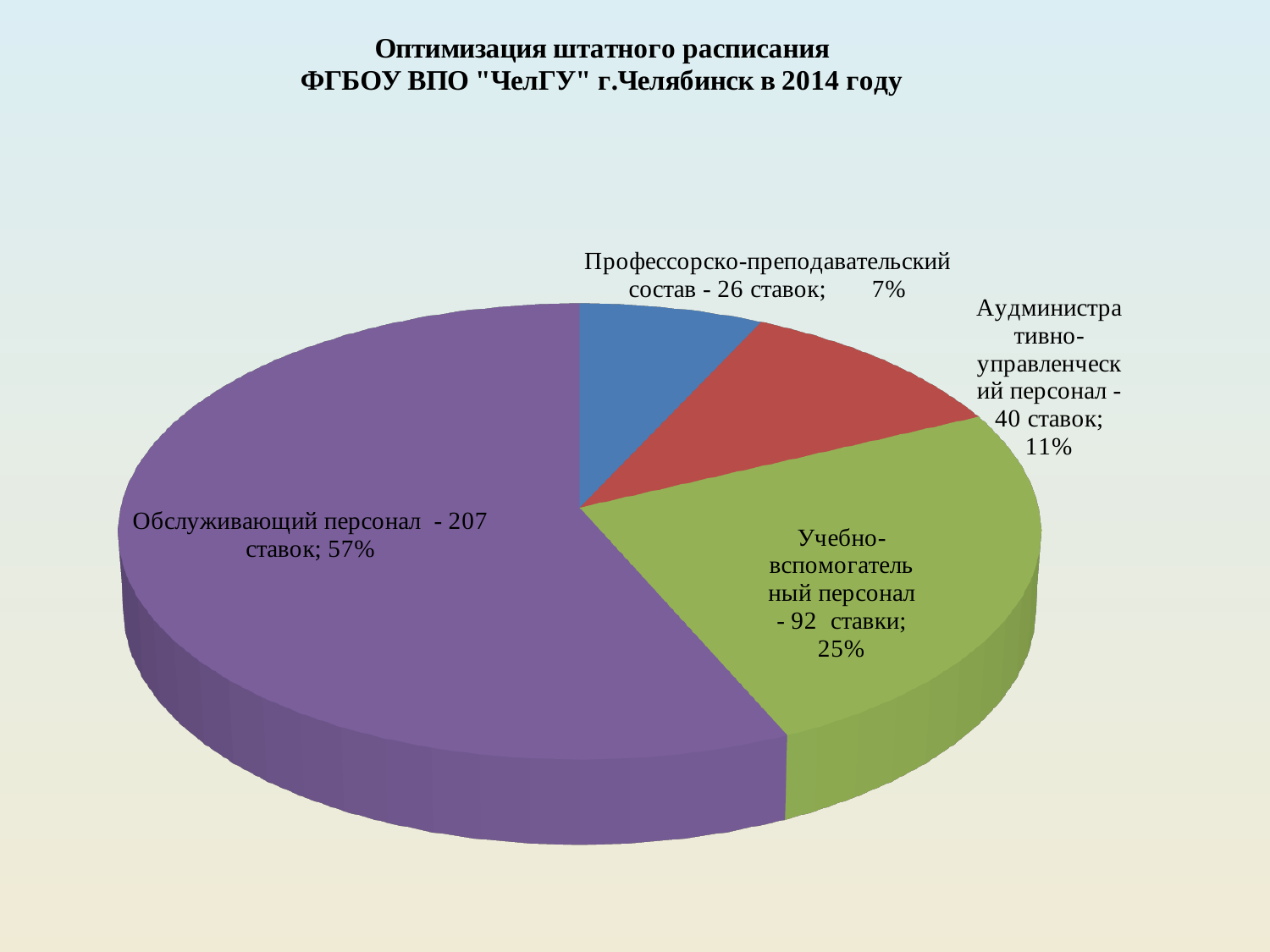
How many ставок does Обслуживающий персонал account for? 207 What is the difference in ставок between Обслуживающий персонал and Учебно-вспомогательный персонал? 115 What percentage share does Учебно-вспомогательный персонал have in the pie chart? 25% Which has more ставок: Административно-управленческий персонал or Профессорско-преподавательский состав? Административно-управленческий персонал What is the total number of ставок across all four categories? 365 Which category has the smallest slice of the pie? Профессорско-преподавательский состав What kind of chart is shown on the slide? Pie chart How many slices does the pie chart have? 4 What colour is the slice for Учебно-вспомогательный персонал? Green How many ставок does Административно-управленческий персонал have? 40 What percentage share does Профессорско-преподавательский состав have? 7% Which category has the largest slice of the pie? Обслуживающий персонал